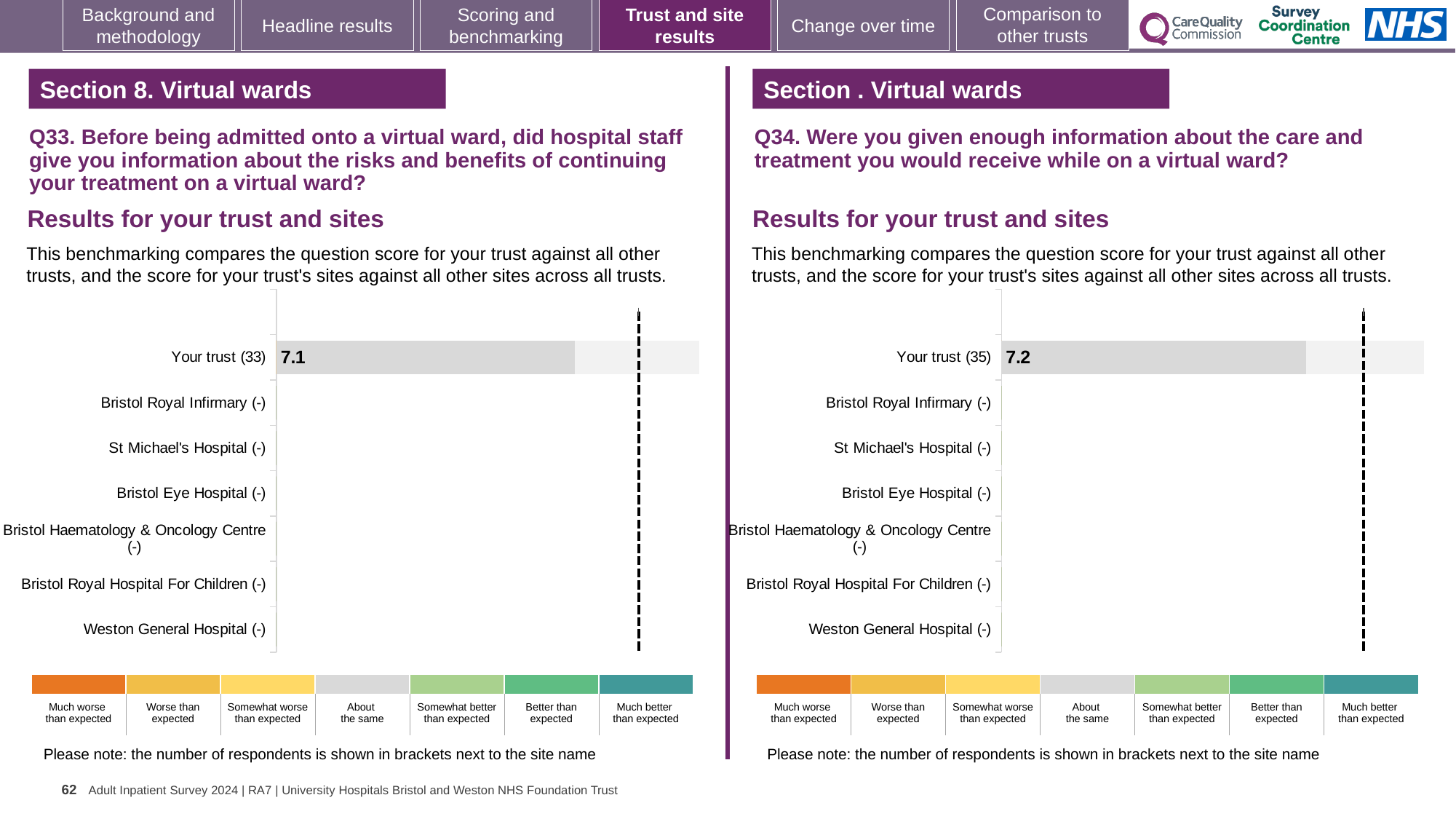
How many site or trust categories are listed on the y axis of the Q34 chart on the right? 7 What is the difference between the Your trust score in the Q34 chart on the right and the Your trust score in the Q33 chart on the left? 0.1 What type of chart is used in the Q33 chart on the left? Bar chart How many benchmark categories does the colour legend below the Q34 chart on the right list? 7 In the Q33 chart on the left, what is the score for Your trust? 7.1 In the Q34 chart on the right, what is shown in brackets next to Weston General Hospital? - In the Q34 chart on the right, how many respondents are shown in brackets next to Your trust? 35 In the Q33 chart on the left, which category is the only one with a plotted bar? Your trust (33) In the Q34 chart on the right, what is the score for Your trust? 7.2 How many site or trust categories are listed on the y axis of the Q33 chart on the left? 7 Which is larger: the Your trust score in the Q33 chart on the left or the Your trust score in the Q34 chart on the right? Q34 (7.2) In the Q33 chart on the left, how many respondents are shown in brackets next to Your trust? 33